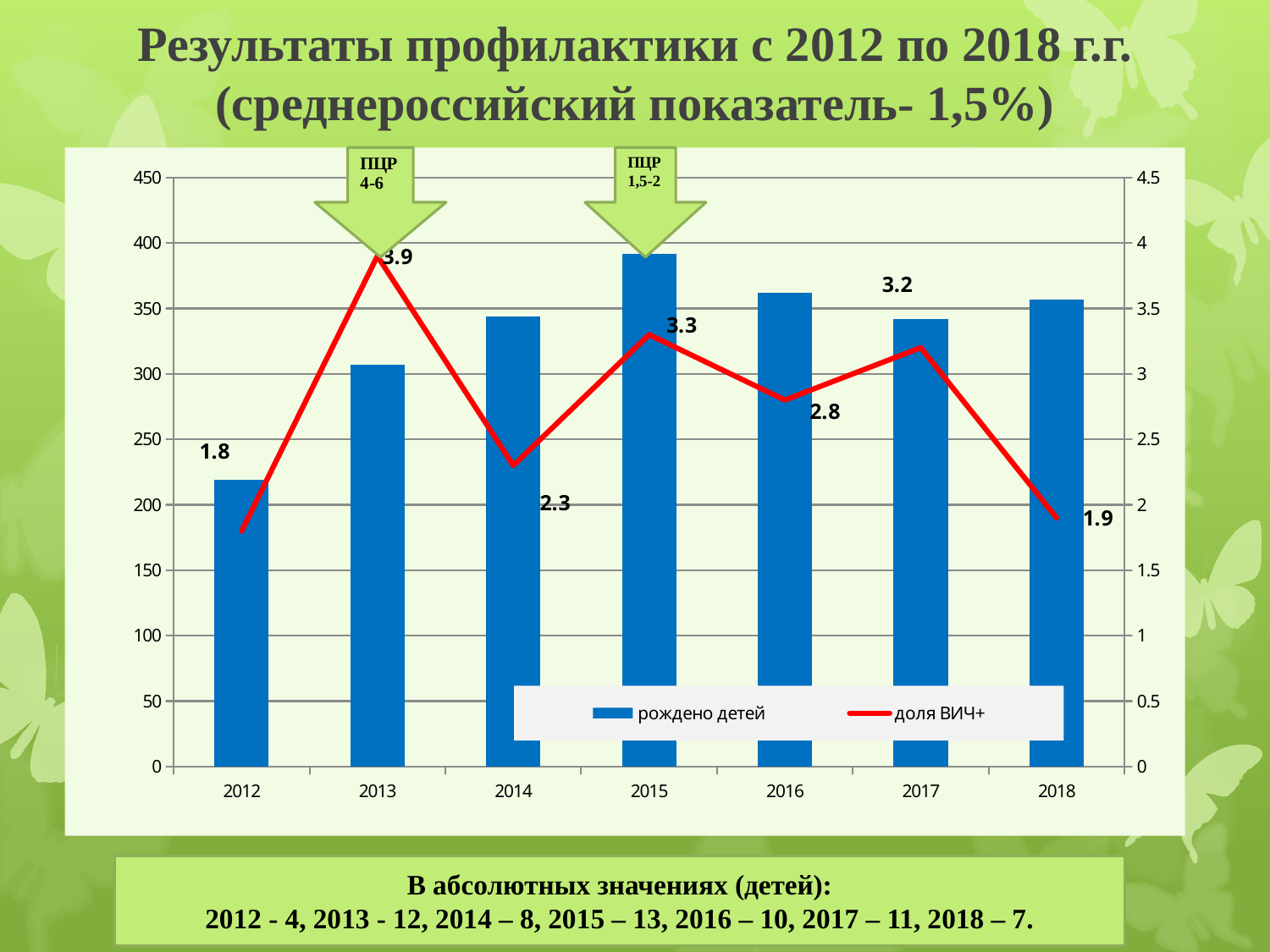
What is the value of доля ВИЧ+ for 2013? 3.9 In which year is доля ВИЧ+ the highest? 2013 In which year is the рождено детей bar the shortest? 2012 In which year is доля ВИЧ+ the lowest? 2012 What is the difference between доля ВИЧ+ in 2013 and in 2012? 2.1 What is the value of доля ВИЧ+ for 2018? 1.9 Is the рождено детей value for 2012 greater or less than 250? less What is the value of доля ВИЧ+ for 2016? 2.8 Is the рождено детей value for 2015 greater or less than 350? greater In which year is the рождено детей bar the tallest? 2015 How many series does the legend list? 2 Which year has a higher доля ВИЧ+ value, 2015 or 2017? 2015